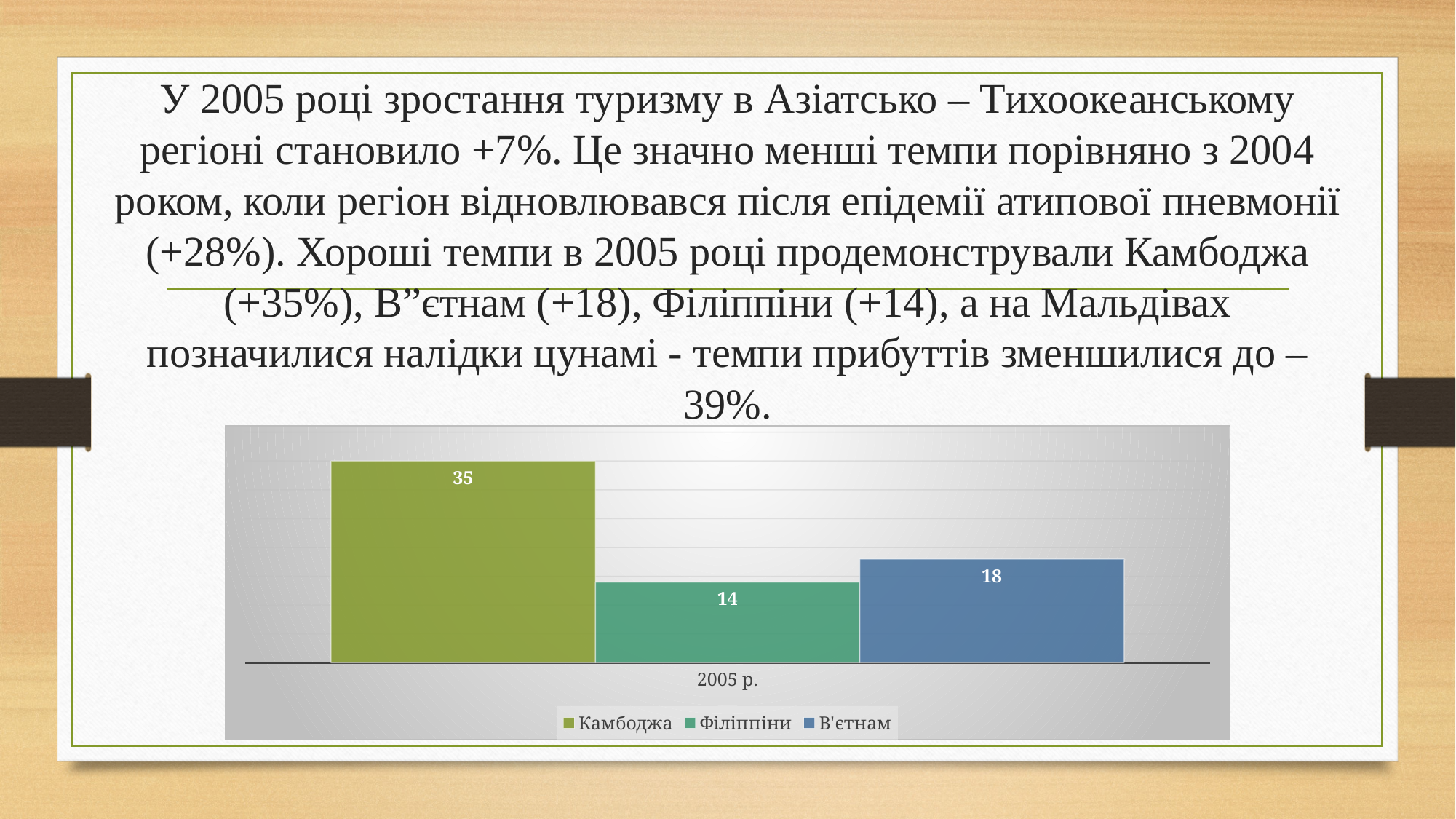
What kind of chart is shown on the slide? bar chart What is the value for Філіппіни in the chart? 14 Which is larger, the value for В'єтнам or the value for Філіппіни? В'єтнам What is the category label shown on the x axis of the chart? 2005 р. What is the difference between the values for В'єтнам and Філіппіни? 4 Which series has the lowest value in the chart? Філіппіни What is the value for Камбоджа in the chart? 35 How many categories are shown on the x axis of the chart? 1 What is the difference between the values for Камбоджа and В'єтнам? 17 How many series does the legend list? 3 What is the value for В'єтнам in the chart? 18 Which series has the highest value in the chart? Камбоджа